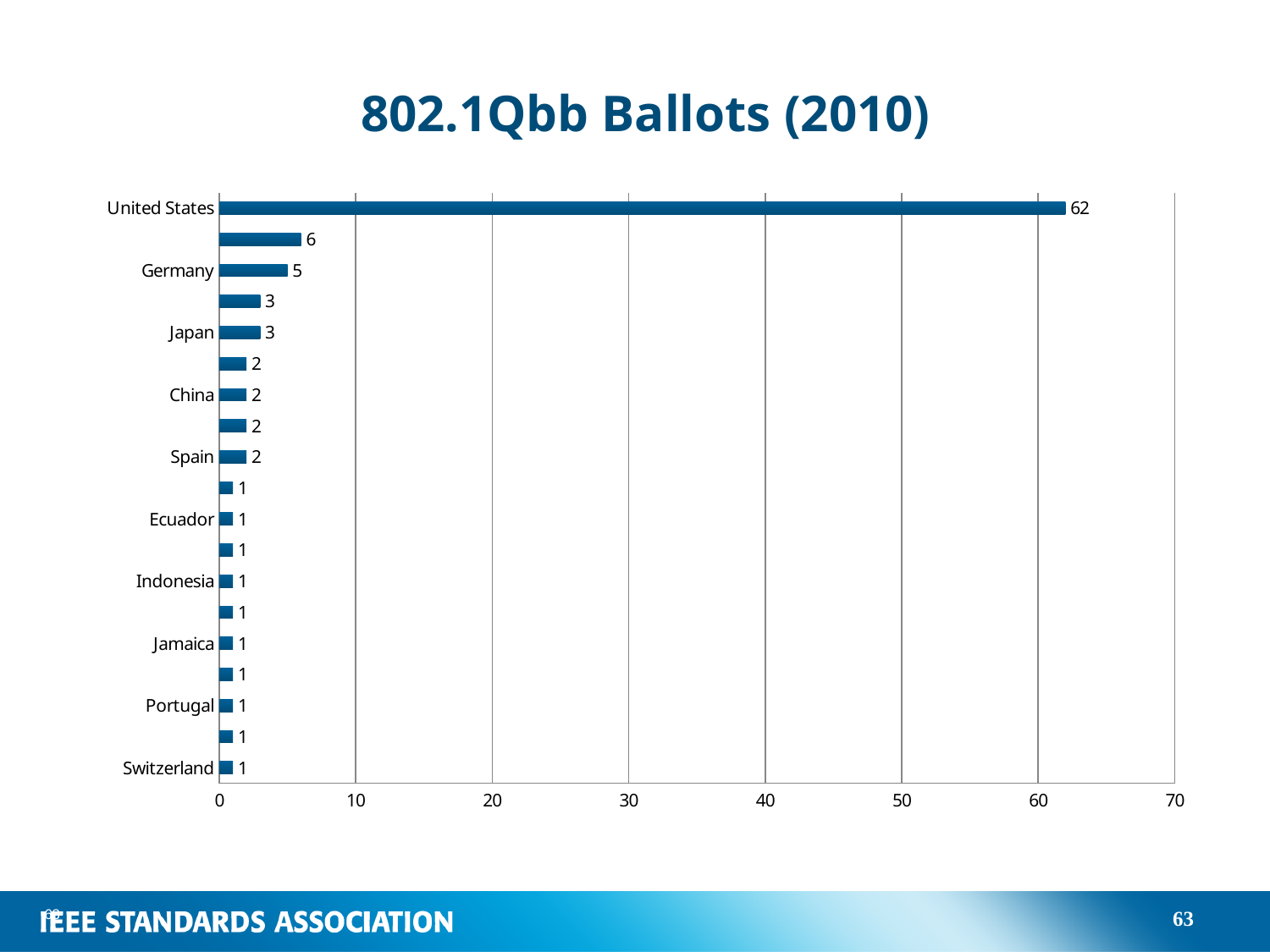
What is the value for Germany? 5 What is the value for Portugal? 1 Is the value for United States greater or less than 60? greater What is the value for Japan? 3 What is the difference between the values for United States and Germany? 57 What is the value for United States? 62 What is the title of the chart? 802.1Qbb Ballots (2010) Which category has the highest value? United States What kind of chart is shown on the slide? Bar chart What is the value for China? 2 Which has a larger value, Germany or Japan? Germany How many bars are plotted in the chart? 19